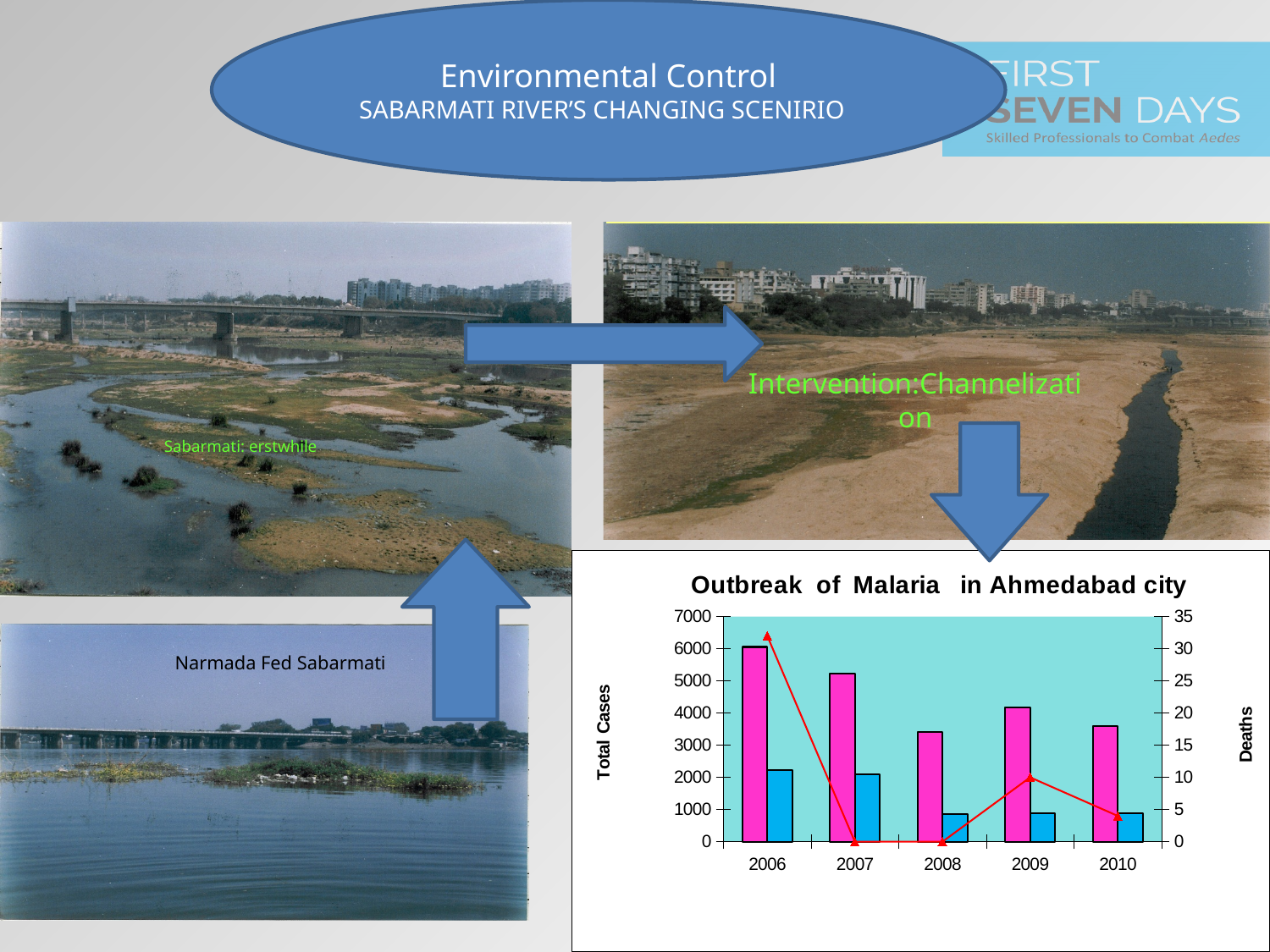
Is the blue bar for 2006 greater or less than 2000 total cases? greater Does the red deaths line rise or fall from 2006 to 2007? fall What kind of chart is used to show the malaria outbreak data? Bar chart with a line What is the title of the chart on the slide? Outbreak of Malaria in Ahmedabad city What is the label of the left vertical axis of the malaria chart? Total Cases In which year is the pink bar the tallest in the malaria chart? 2006 Is the pink bar for 2008 greater or less than 4000 total cases? less What value does the red deaths line show for 2007? 0 Is the pink bar for 2006 greater or less than 5000 total cases? greater How many years are shown on the x axis of the malaria chart? 5 Which is larger, the pink bar for 2007 or the pink bar for 2009? 2007